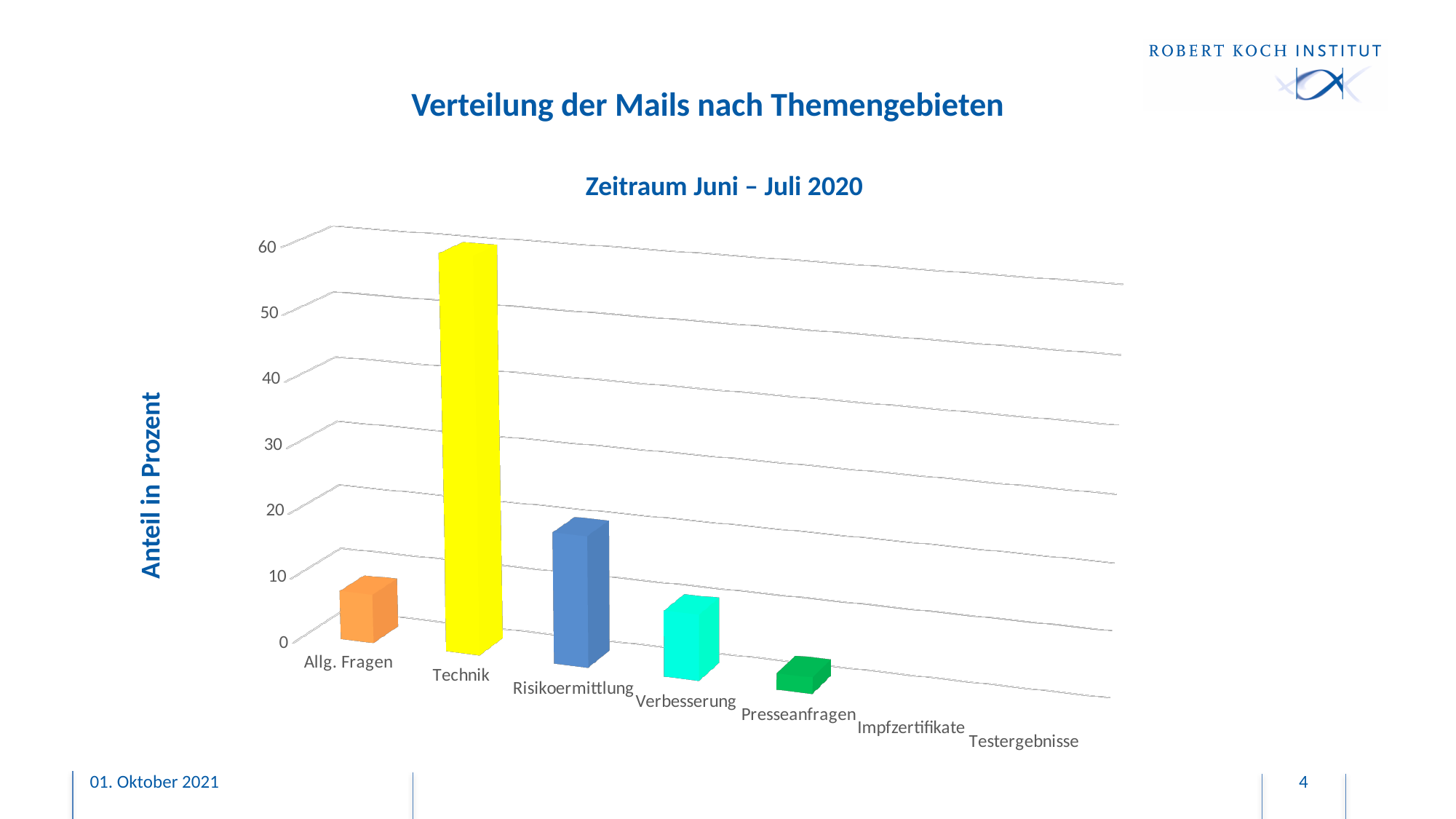
Is the value for Technik greater or less than 40? greater Is the value for Allg. Fragen greater or less than 20? less What colour is the bar for Technik? yellow Which is larger, the value for Allg. Fragen or the value for Presseanfragen? Allg. Fragen How many categories are labelled on the x axis? 7 Which is larger, the value for Technik or the value for Risikoermittlung? Technik What is the label of the vertical axis? Anteil in Prozent What kind of chart is shown on the slide? bar chart Which is larger, the value for Risikoermittlung or the value for Verbesserung? Risikoermittlung Is the value for Presseanfragen greater or less than 10? less Which of the bars shown is the shortest? Presseanfragen Which category has the highest value? Technik